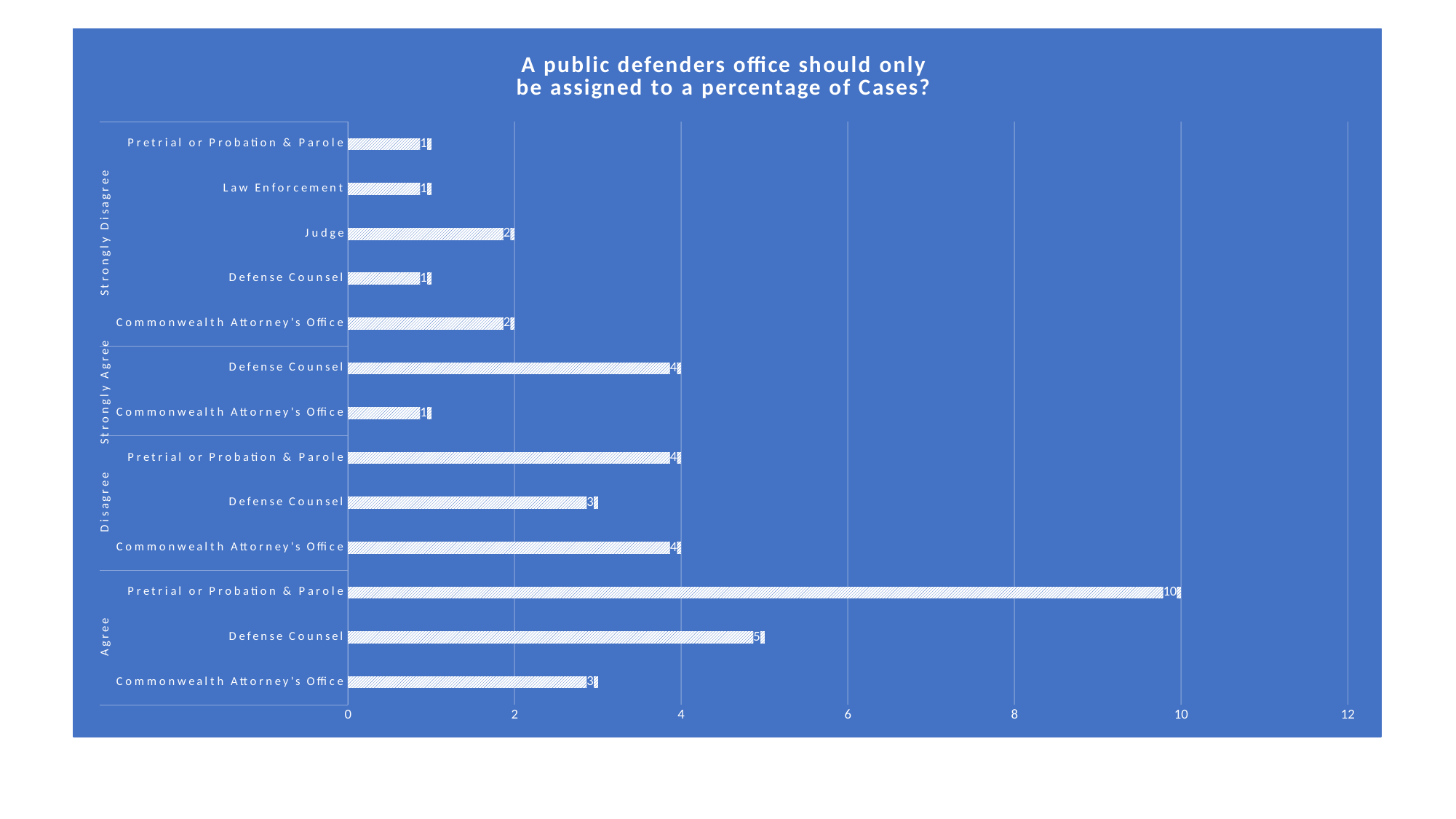
What is the difference between Defense Counsel under Agree and Defense Counsel under Disagree? 2 What kind of chart is shown on the slide? bar chart What is the title of the chart? A public defenders office should only be assigned to a percentage of Cases? Which is larger: Defense Counsel under Strongly Agree or Commonwealth Attorney's Office under Strongly Agree? Defense Counsel under Strongly Agree What is the value for Judge under Strongly Disagree? 2 What is the value for Defense Counsel under Strongly Agree? 4 What is the value for Commonwealth Attorney's Office under Disagree? 4 What is the total of the three bars in the Agree group? 18 How many bars are plotted on the chart? 13 Which bar has the highest value on the chart? Pretrial or Probation & Parole (Agree) Is the value for Pretrial or Probation & Parole under Agree greater or less than 8? greater What is the value for Pretrial or Probation & Parole under Agree? 10